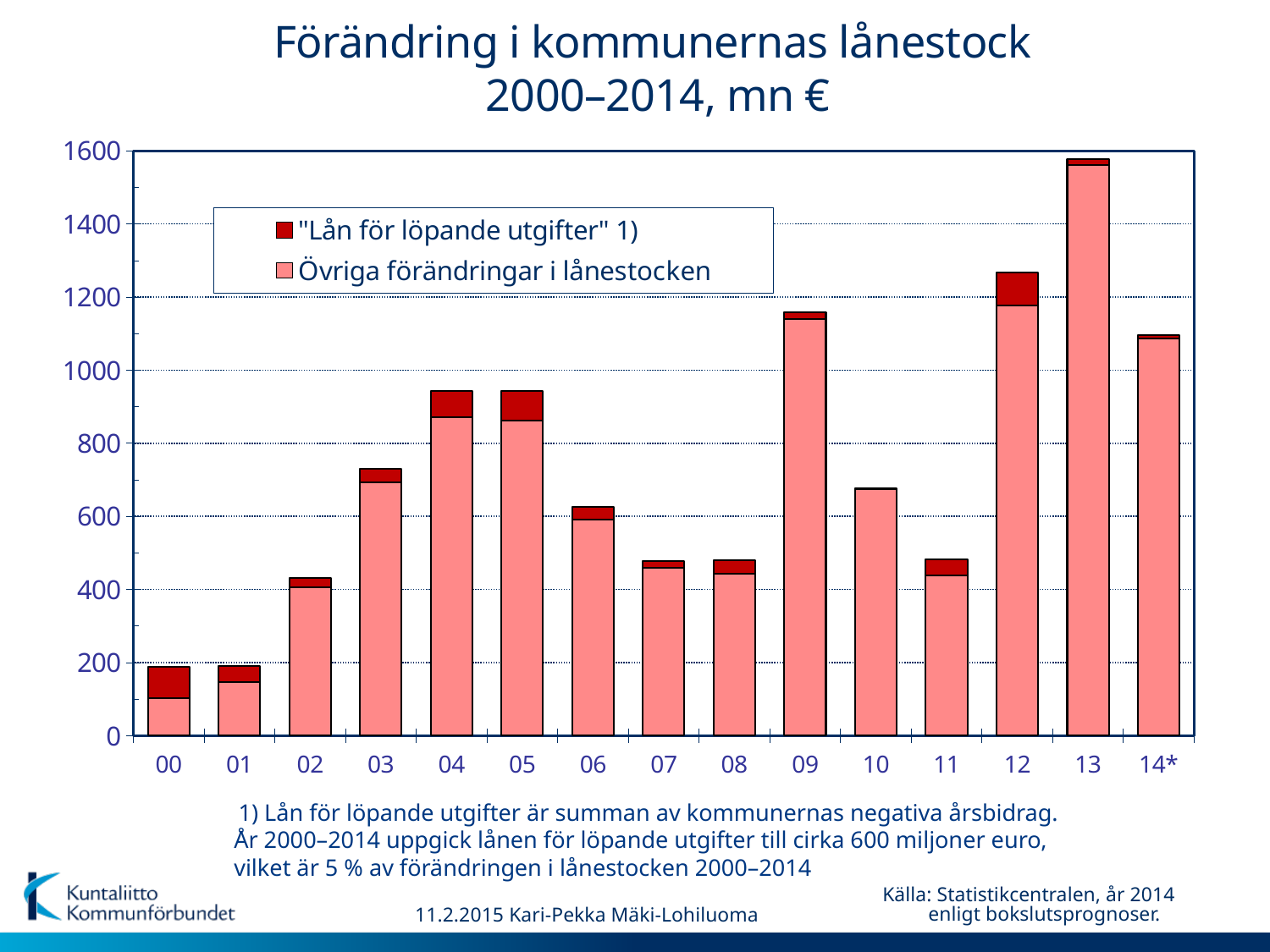
Is the total value for 09 greater or less than 1000? greater What kind of chart is shown on the slide? Stacked bar chart Is the total value for 03 greater or less than 800? less Which total bar is larger, 12 or 14*? 12 Which total bar is larger, 09 or 10? 09 Do the total bars rise or fall from 01 to 04? rise How many years (bars) are shown on the x axis? 15 How many series does the legend list? 2 Is the total value for 07 greater or less than 600? less Which year has the highest total bar? 13 What is the title of the chart? Förändring i kommunernas lånestock 2000–2014, mn €